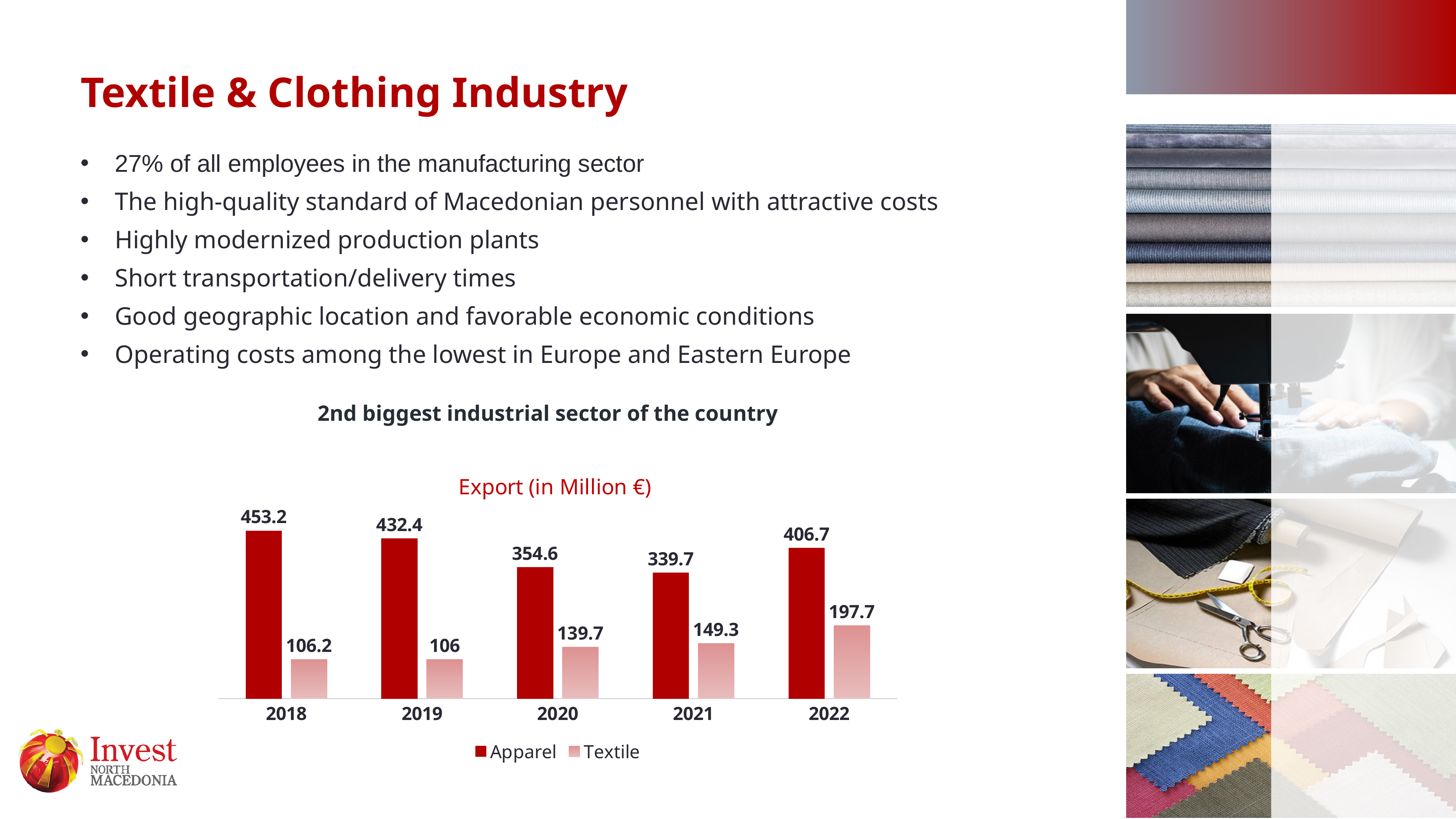
Which year has the highest Apparel export value? 2018 What is the difference between the Apparel and Textile export values in 2022? 209 What kind of chart is shown on the slide? Bar chart Do the Textile export values rise or fall from 2019 to 2022? Rise Which year has the lowest Apparel export value? 2021 Which year has the lowest Textile export value? 2019 What is the Textile export value for 2022? 197.7 How many years are shown on the x axis of the chart? 5 What is the Textile export value for 2019? 106 How many series does the chart legend list? 2 What is the Apparel export value for 2018? 453.2 Is the Apparel export value in 2020 larger than the Apparel export value in 2021? Yes